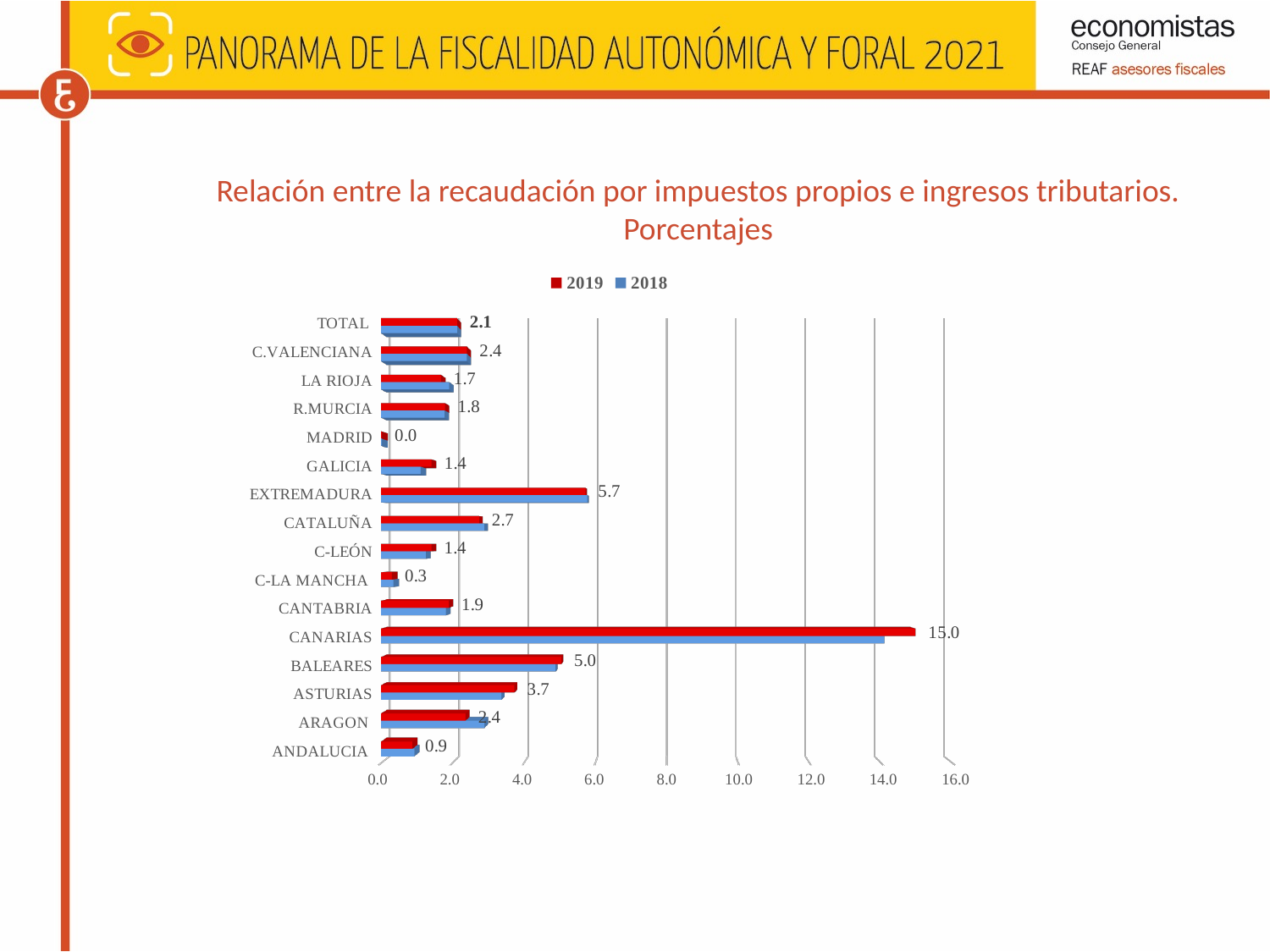
How many categories are shown on the chart? 16 What is the 2019 value for TOTAL? 2.1 What is the 2019 value for ANDALUCIA? 0.9 What kind of chart is shown on the slide? Bar chart Is the 2018 value for CANARIAS greater or less than 12.0? greater Which category has the lowest 2019 value? MADRID What is the 2019 value for CANARIAS? 15.0 What is the 2019 value for EXTREMADURA? 5.7 Which category has the highest 2019 value? CANARIAS How many series does the legend list? 2 What is the difference between the 2019 values for CANARIAS and BALEARES? 10.0 Which has a larger 2019 value, ASTURIAS or CATALUÑA? ASTURIAS